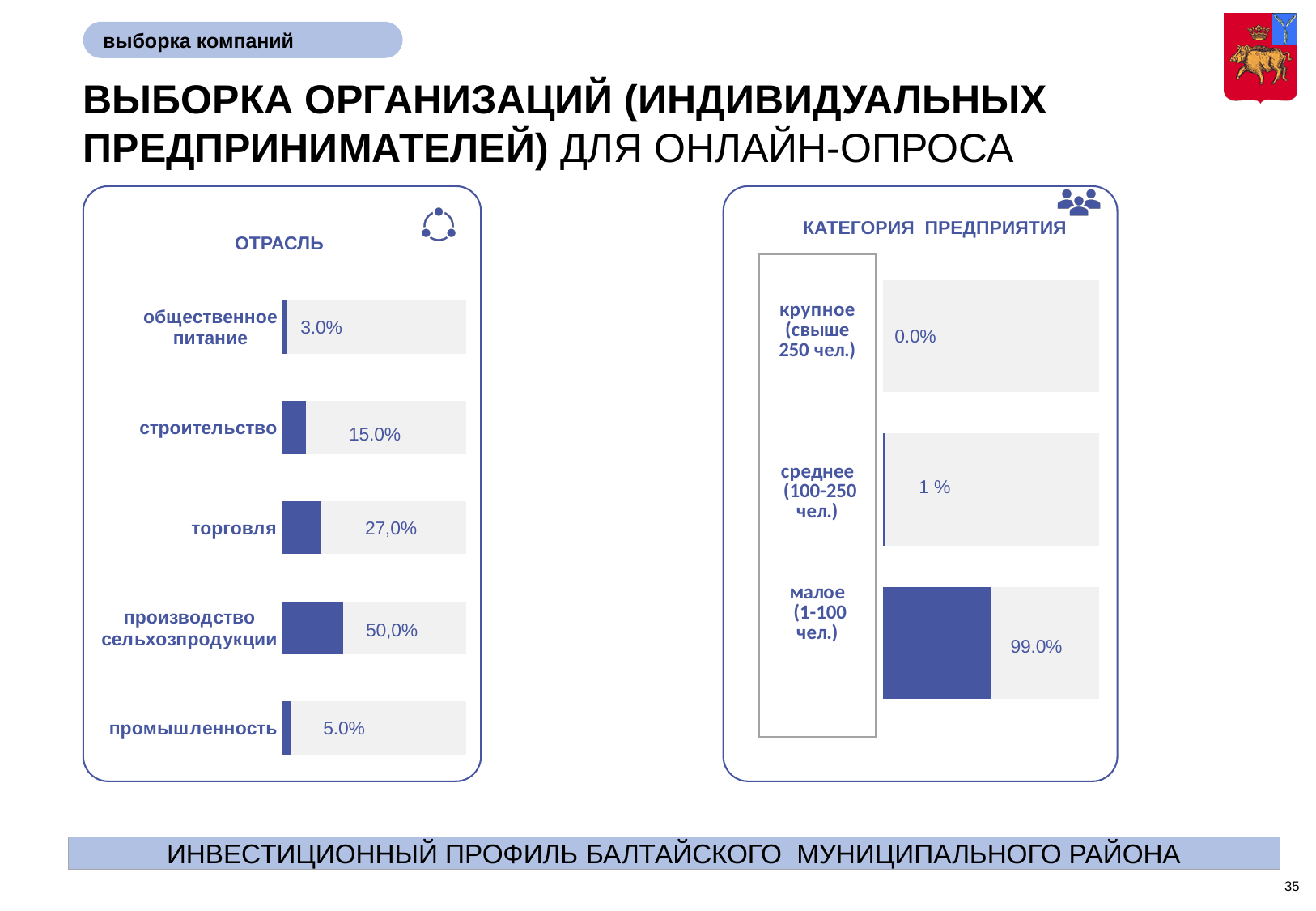
In the "ОТРАСЛЬ" chart, what is the value for строительство? 15.0% In the "КАТЕГОРИЯ ПРЕДПРИЯТИЯ" chart, what is the value for малое (1-100 чел.)? 99.0% In the "ОТРАСЛЬ" chart, what is the value for торговля? 27,0% What kind of chart is the "ОТРАСЛЬ" chart? bar chart In the "ОТРАСЛЬ" chart, what is the difference between производство сельхозпродукции and торговля? 23,0 percentage points In the "КАТЕГОРИЯ ПРЕДПРИЯТИЯ" chart, how many categories are shown? 3 In the "ОТРАСЛЬ" chart, which category has the highest value? производство сельхозпродукции In the "ОТРАСЛЬ" chart, how many categories are shown? 5 In the "КАТЕГОРИЯ ПРЕДПРИЯТИЯ" chart, what is the value for крупное (свыше 250 чел.)? 0.0% In the "ОТРАСЛЬ" chart, which is larger: промышленность or строительство? строительство In the "КАТЕГОРИЯ ПРЕДПРИЯТИЯ" chart, which category has the highest value? малое (1-100 чел.) In the "ОТРАСЛЬ" chart, which category has the lowest value? общественное питание